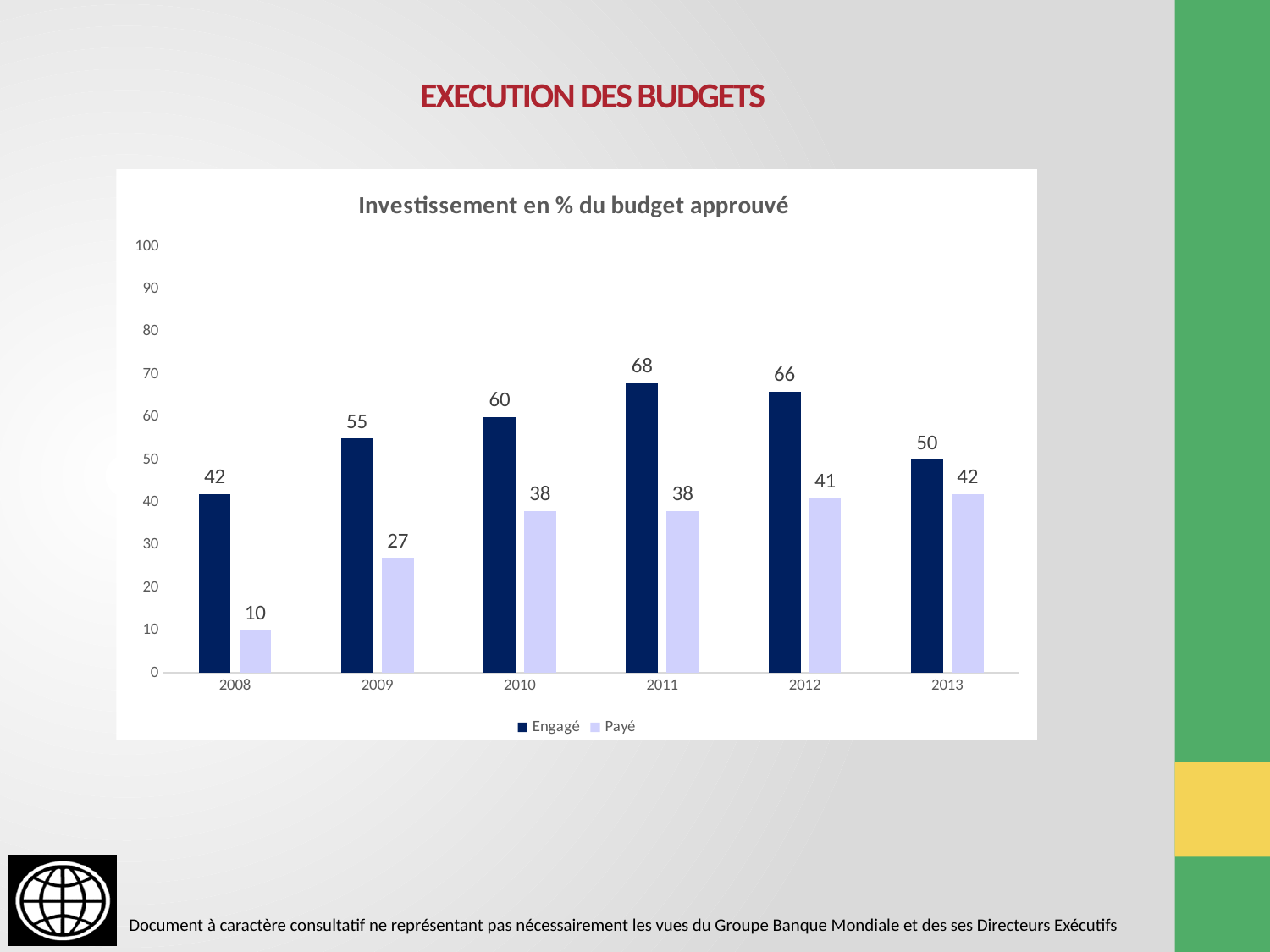
What is the difference between the Engagé and Payé values in 2009? 28 Which year has the lowest Payé value? 2008 How many series does the legend list? 2 How many years are shown on the x axis? 6 Which is larger, the Engagé value for 2010 or the Engagé value for 2013? 2010 What kind of chart is shown? bar chart What is the Engagé value for 2011? 68 What is the Payé value for 2008? 10 Is the Engagé value for 2012 greater or less than 60? greater What is the Payé value for 2012? 41 Which year has the highest Engagé value? 2011 What is the title of the chart? Investissement en % du budget approuvé